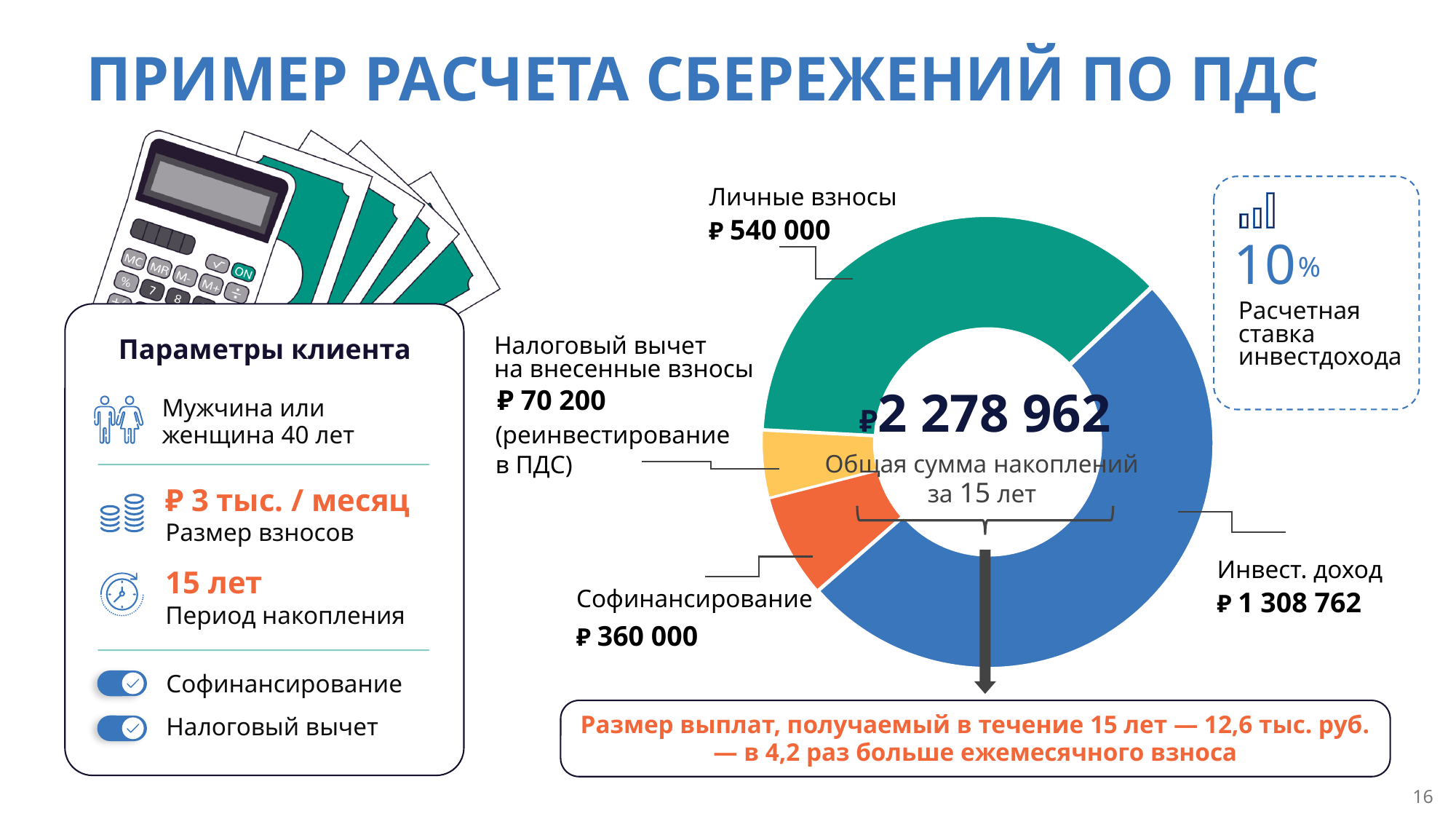
Which segment of the donut chart has the smallest value? Налоговый вычет на внесенные взносы What is the difference between Личные взносы and Софинансирование in the donut chart? ₽ 180 000 How many segments does the donut chart have? 4 What is the value for Инвест. доход in the donut chart? ₽ 1 308 762 What is the difference between Инвест. доход and Личные взносы in the donut chart? ₽ 768 762 What is the value for Софинансирование in the donut chart? ₽ 360 000 What total amount (Общая сумма накоплений за 15 лет) is shown in the center of the donut chart? ₽2 278 962 Which segment of the donut chart has the largest value? Инвест. доход What type of chart is shown on the slide? Donut (pie) chart What is the value for Личные взносы in the donut chart? ₽ 540 000 Which is larger in the donut chart: Личные взносы or Софинансирование? Личные взносы What is the value for Налоговый вычет на внесенные взносы in the donut chart? ₽ 70 200